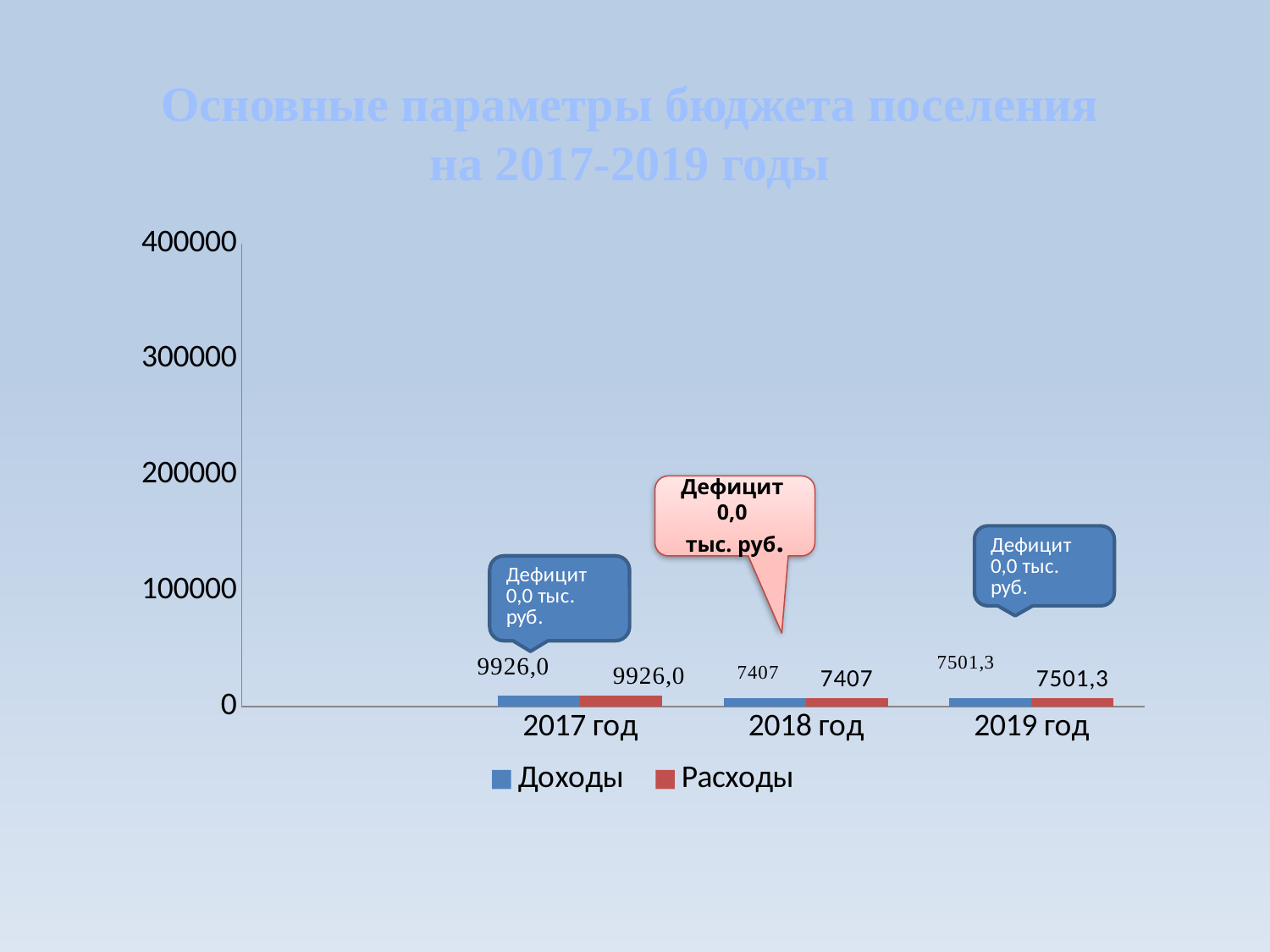
In which year are Расходы lowest? 2018 год What is the difference between Доходы in 2019 год and Доходы in 2018 год? 94,3 What kind of chart is shown on the slide? bar chart What is the value of Доходы for 2019 год? 7501,3 How many years are shown on the x axis? 3 How many series does the legend list? 2 What is the value of Доходы for 2017 год? 9926,0 Is the value of Доходы for 2017 год greater or less than 100000? less In which year are Доходы highest? 2017 год What is the value of Расходы for 2018 год? 7407 Which is larger: Расходы in 2017 год or Расходы in 2019 год? Расходы in 2017 год Do Доходы rise or fall from 2017 год to 2018 год? fall